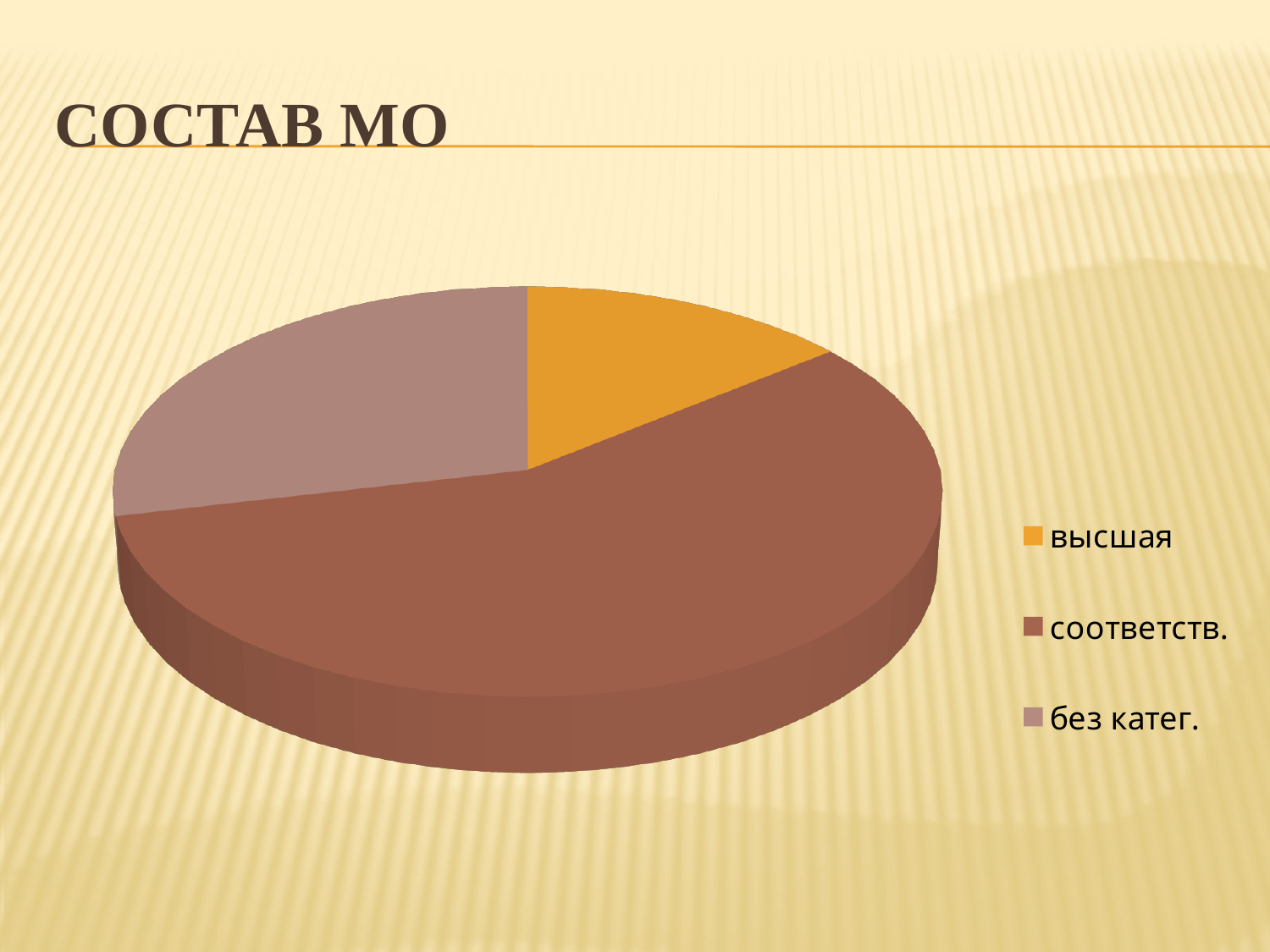
Which category has the largest slice in the pie chart? соответств. How many entries does the legend of the pie chart list? 3 Does the "соответств." slice take up more or less than half of the pie? more What is the title of the slide containing the pie chart? СОСТАВ МО Which slice is larger, "высшая" or "без катег."? без катег. What colour is the "высшая" slice in the pie chart? orange How many slices does the pie chart have? 3 Which slice is larger, "соответств." or "без катег."? соответств. Which category has the smallest slice in the pie chart? высшая What kind of chart is shown on the slide? pie chart